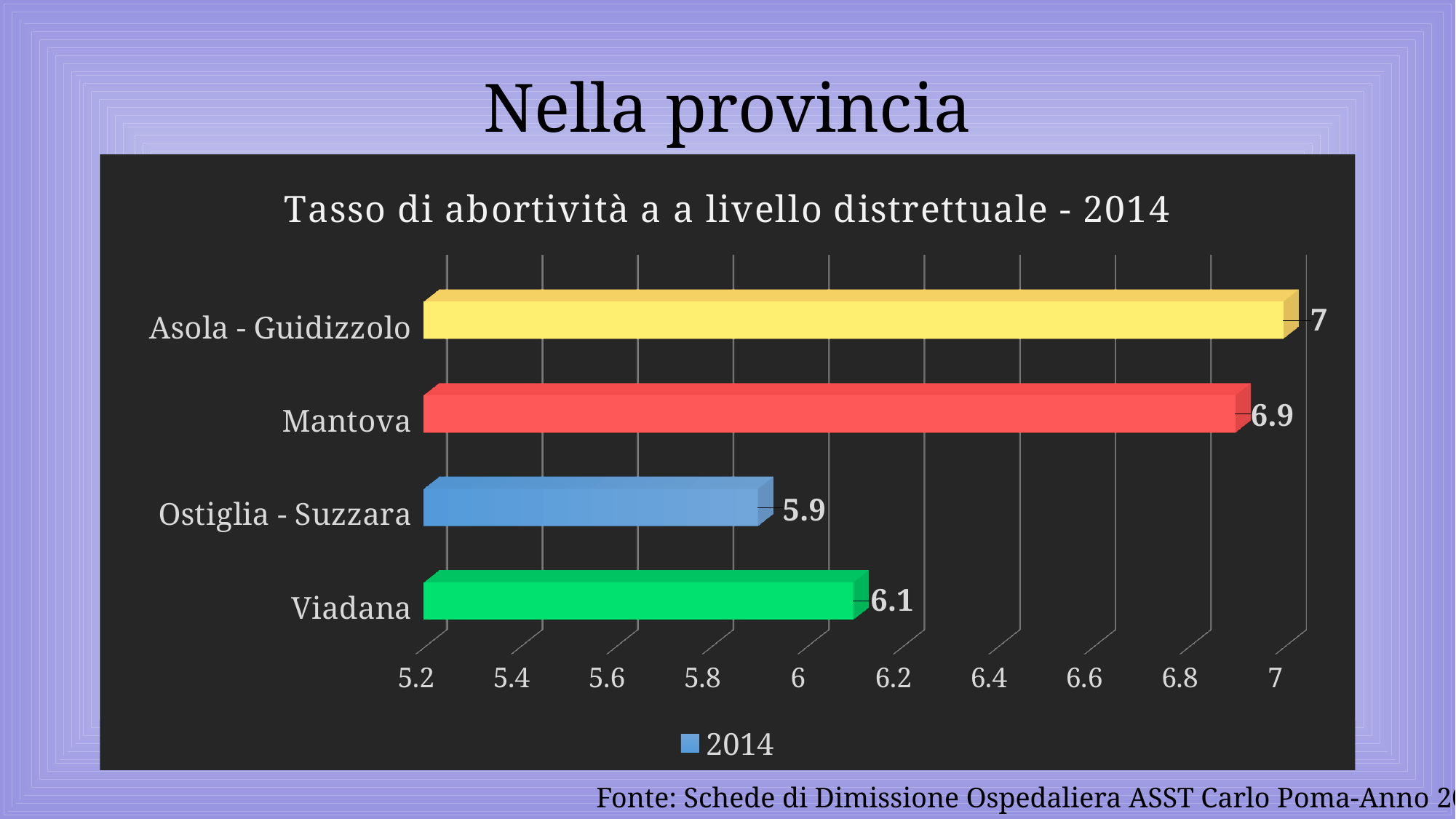
What is the difference between the values for Asola - Guidizzolo and Ostiglia - Suzzara? 1.1 What is the value for Asola - Guidizzolo? 7 What is the difference between the values for Mantova and Viadana? 0.8 Which district has the highest value? Asola - Guidizzolo What kind of chart is shown on the slide? bar chart Which is larger, the value for Viadana or the value for Ostiglia - Suzzara? Viadana What is the value for Mantova? 6.9 What is the title of the chart? Tasso di abortività a a livello distrettuale - 2014 How many districts are shown in the chart? 4 What is the value for Viadana? 6.1 Which district has the lowest value? Ostiglia - Suzzara What is the value for Ostiglia - Suzzara? 5.9